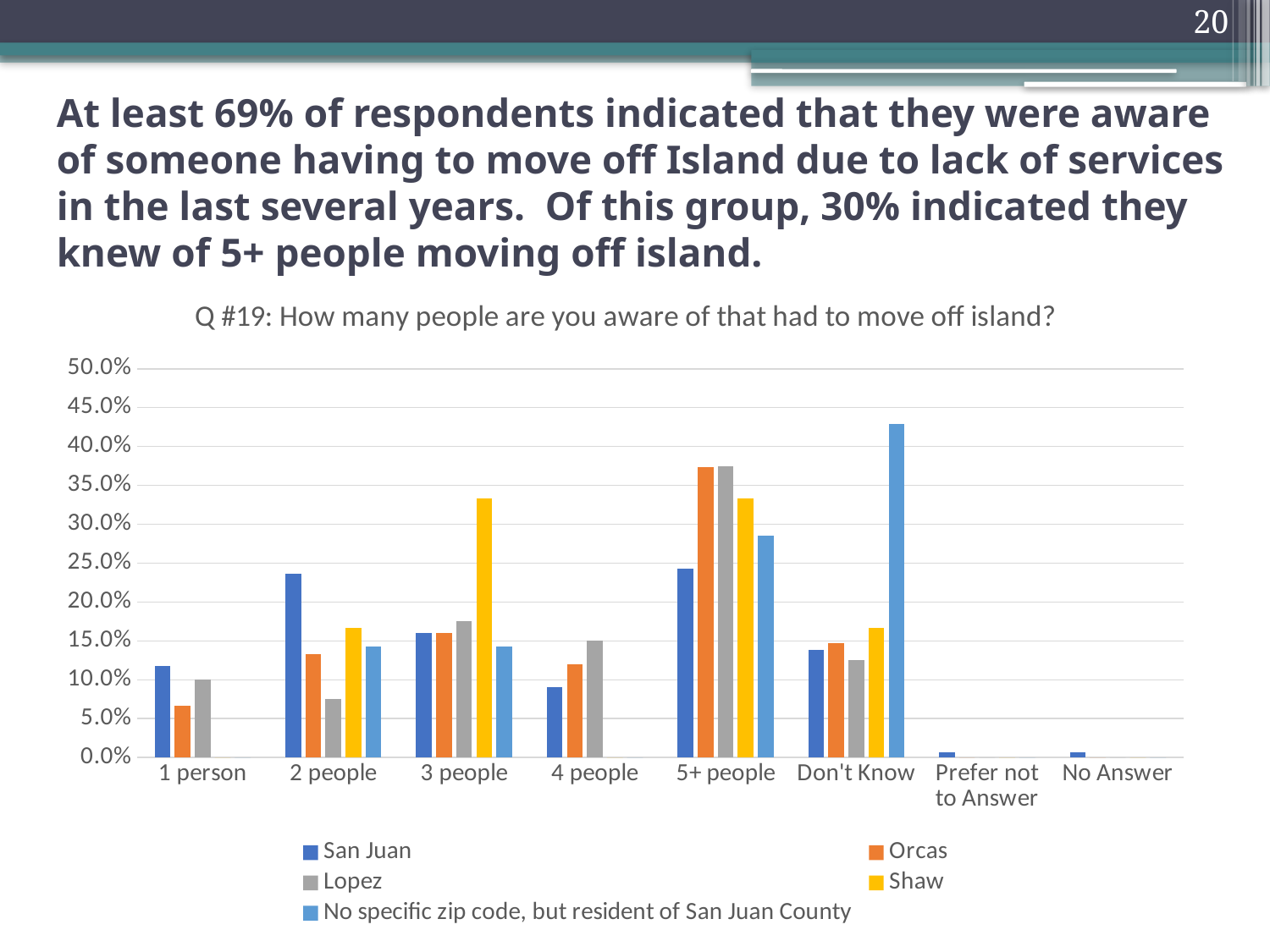
For the 2 people category, which is larger: San Juan or Orcas? San Juan What kind of chart is shown on the slide? Bar chart How many response categories are shown along the x axis? 8 Is the San Juan value for 2 people greater or less than 20%? greater Is the value for 'No specific zip code, but resident of San Juan County' in the Don't Know category greater or less than 40%? greater How many series does the legend list? 5 Is the Orcas value for 1 person greater or less than 10%? less What is the title of the chart? Q #19: How many people are you aware of that had to move off island? In which category does Orcas have its highest value? 5+ people Which series has the lowest value in the 2 people category? Lopez For the 5+ people category, which is larger: Shaw or 'No specific zip code, but resident of San Juan County'? Shaw